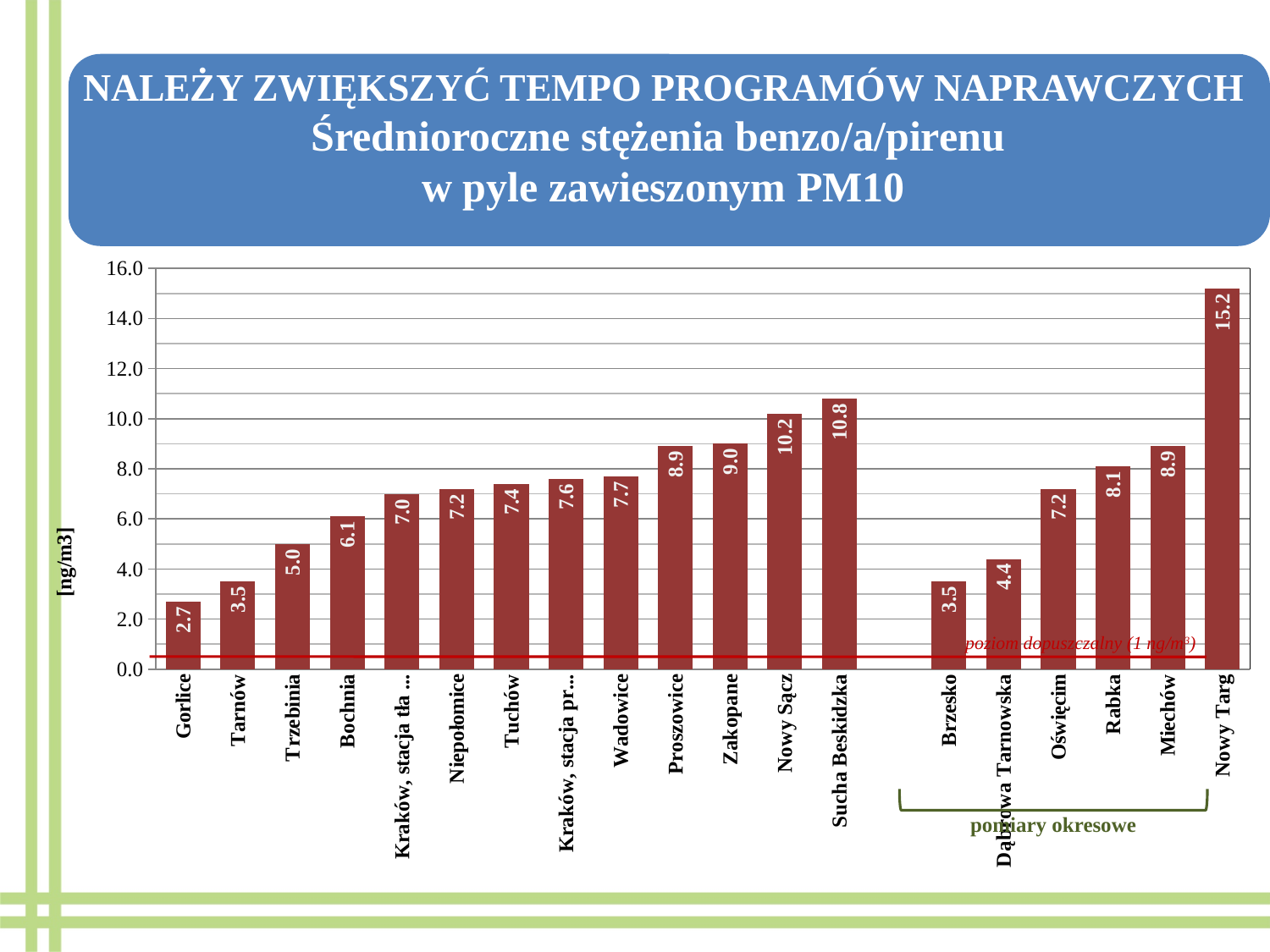
Which has a larger value, Rabka or Oświęcim? Rabka What kind of chart is shown on the slide? Bar chart What is the difference between the values for Nowy Targ and Sucha Beskidzka? 4.4 What unit is shown on the vertical axis label? [ng/m3] What is the value for Nowy Targ? 15.2 Which location has the highest value? Nowy Targ What is the value for Dąbrowa Tarnowska? 4.4 What is the value for Sucha Beskidzka? 10.8 How many locations are shown as bars in the chart? 19 What is the value for Gorlice? 2.7 Which location has the lowest value? Gorlice What is the difference between the values for Nowy Sącz and Bochnia? 4.1